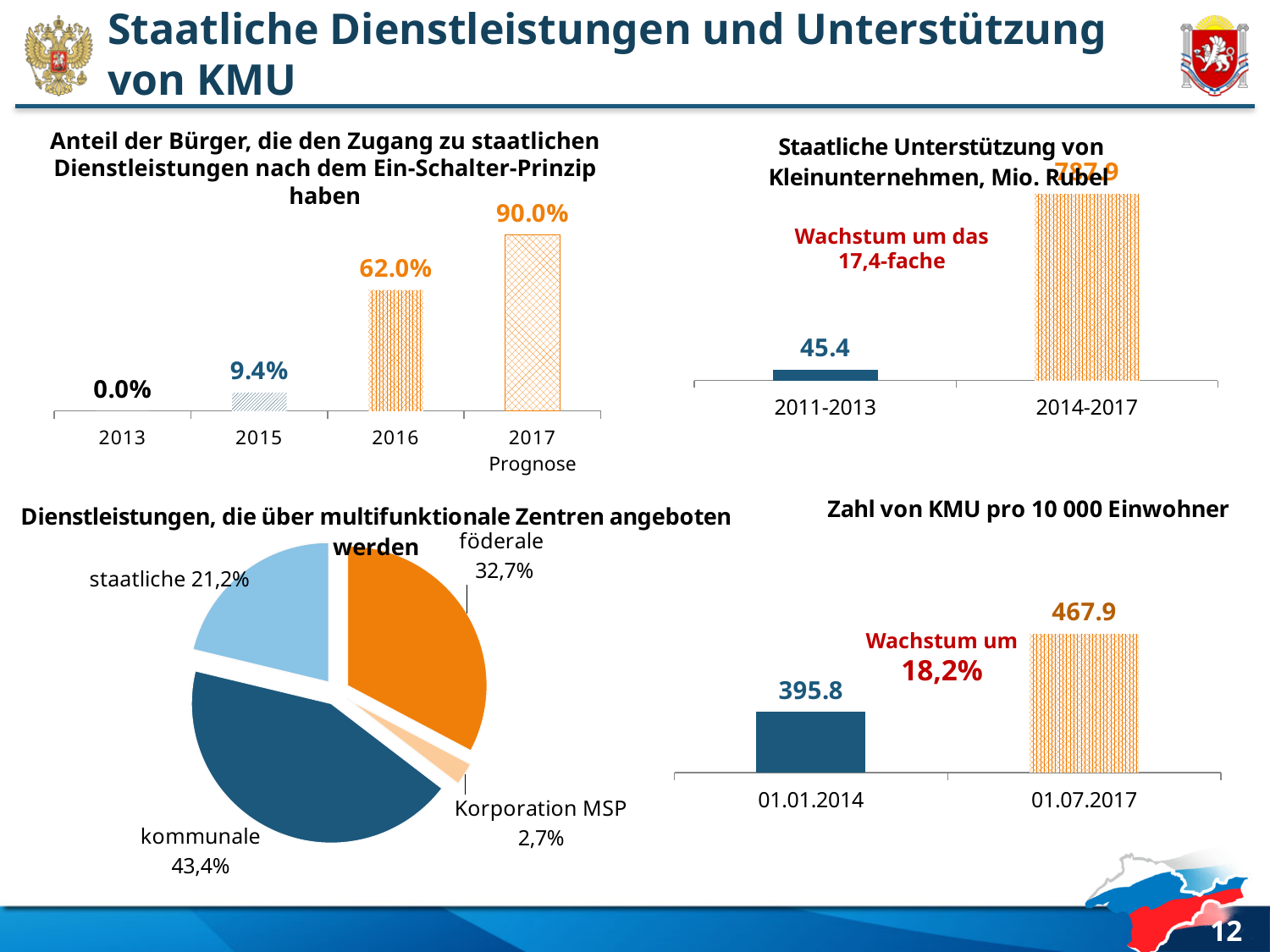
In the top-left chart (Anteil der Bürger ... Ein-Schalter-Prinzip), which year has the highest value? 2017 Prognose In the bottom-left pie chart, which category has the smallest slice? Korporation MSP In the bottom-right chart (Zahl von KMU pro 10 000 Einwohner), what is the difference between the 01.07.2017 value and the 01.01.2014 value? 72.1 In the top-left chart (Anteil der Bürger ... Ein-Schalter-Prinzip), what is the value for 2016? 62.0% In the top-right chart (Staatliche Unterstützung von Kleinunternehmen, Mio. Rubel), which period has the larger value, 2011-2013 or 2014-2017? 2014-2017 In the bottom-right chart (Zahl von KMU pro 10 000 Einwohner), what is the value for 01.07.2017? 467.9 In the top-left chart (Anteil der Bürger ... Ein-Schalter-Prinzip), do the values rise or fall from 2013 to 2017? rise In the top-left chart (Anteil der Bürger ... Ein-Schalter-Prinzip), what is the difference between the 2017 Prognose value and the 2016 value? 28.0% In the top-right chart (Staatliche Unterstützung von Kleinunternehmen, Mio. Rubel), what is the value for 2011-2013? 45.4 In the top-left chart (Anteil der Bürger ... Ein-Schalter-Prinzip), how many categories are shown on the x axis? 4 What kind of chart is the bottom-left chart (Dienstleistungen, die über multifunktionale Zentren angeboten werden)? pie chart In the bottom-left pie chart, what share do kommunale services have? 43,4%